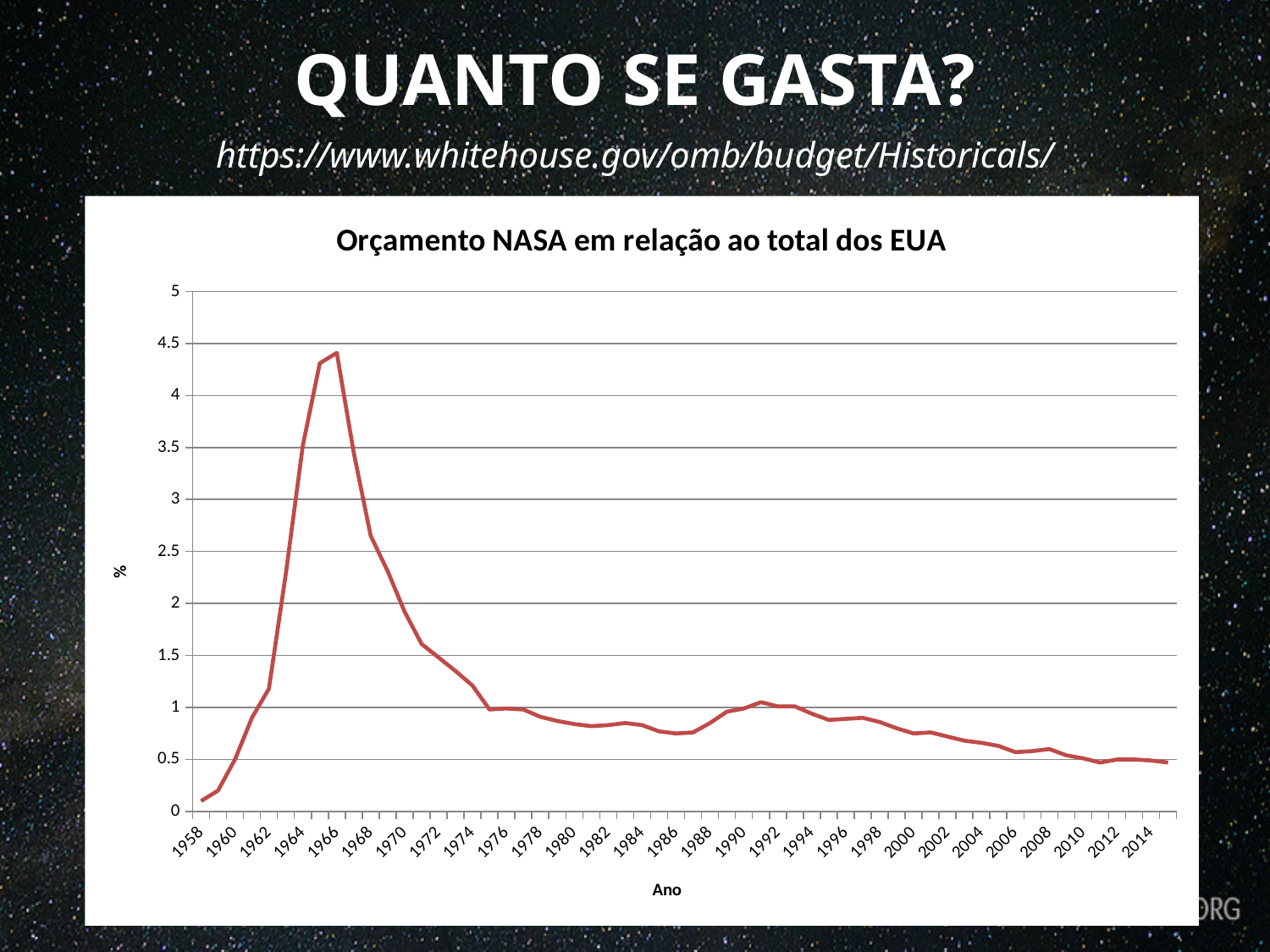
Is the value for 1958 greater or less than 0.5? less Is the value for 1964 greater or less than 3? greater What is the label of the x axis of the chart? Ano Which year has the larger value, 1966 or 2014? 1966 In which year does the line reach its highest value? 1966 Does the line rise or fall between 1966 and 1976? fall Is the value for 1972 greater or less than 1? greater What is the title of the chart? Orçamento NASA em relação ao total dos EUA In which year does the line have its lowest value? 1958 What kind of chart is shown on the slide? line chart